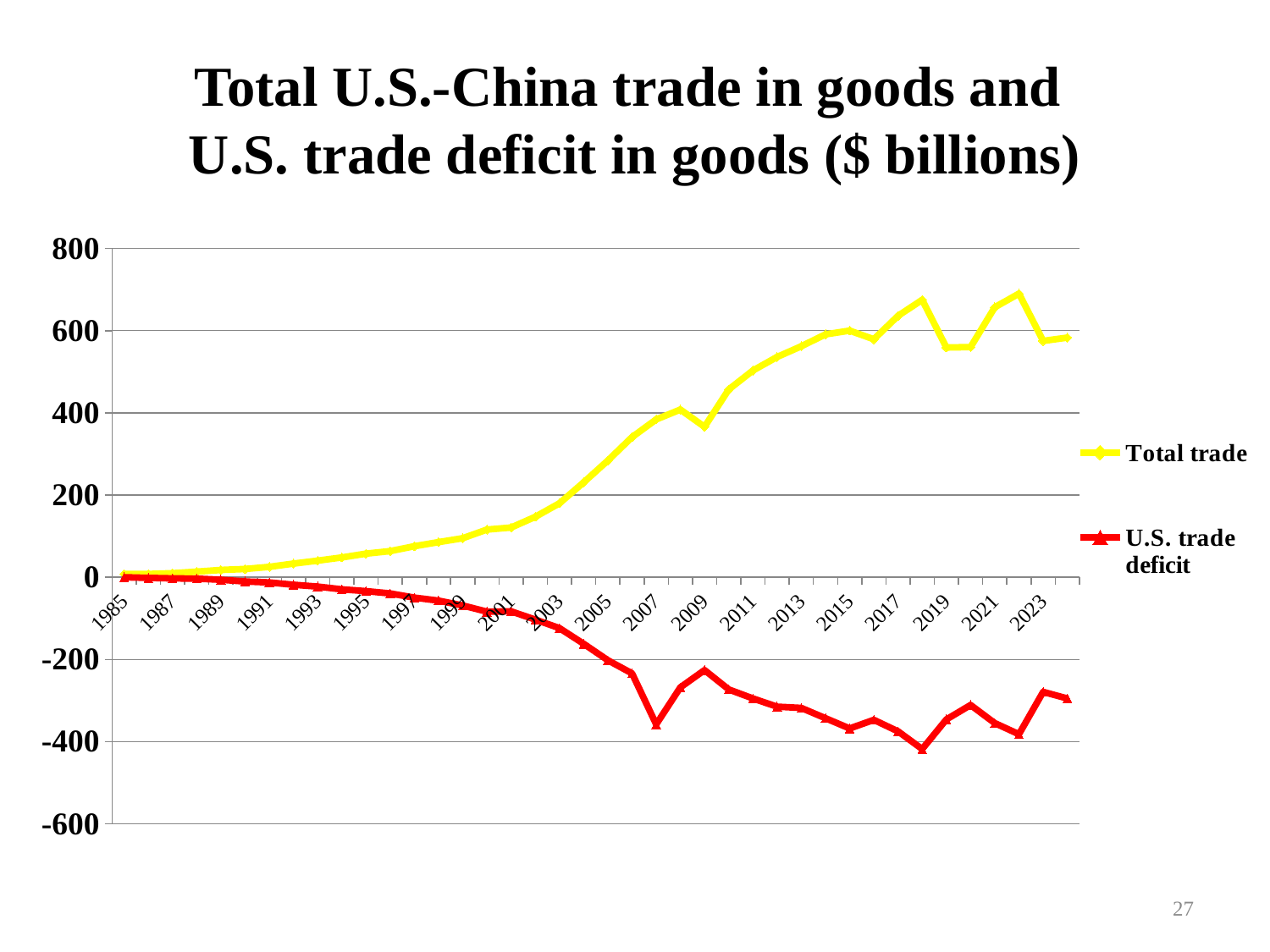
Is the value for Total trade in 2009 greater or less than 400? less Does the Total trade line rise or fall from 1985 to 2005? Rises Is the value for U.S. trade deficit in 2013 greater or less than -200? less Which is larger, Total trade in 2011 or Total trade in 2009? 2011 What are the two series named in the legend? Total trade and U.S. trade deficit Is the value for U.S. trade deficit in 1995 greater or less than -200? greater Which colour is used for the Total trade line? Yellow How many year labels are shown on the x axis? 20 How many series does the legend list? 2 What kind of chart is shown on the slide? Line chart